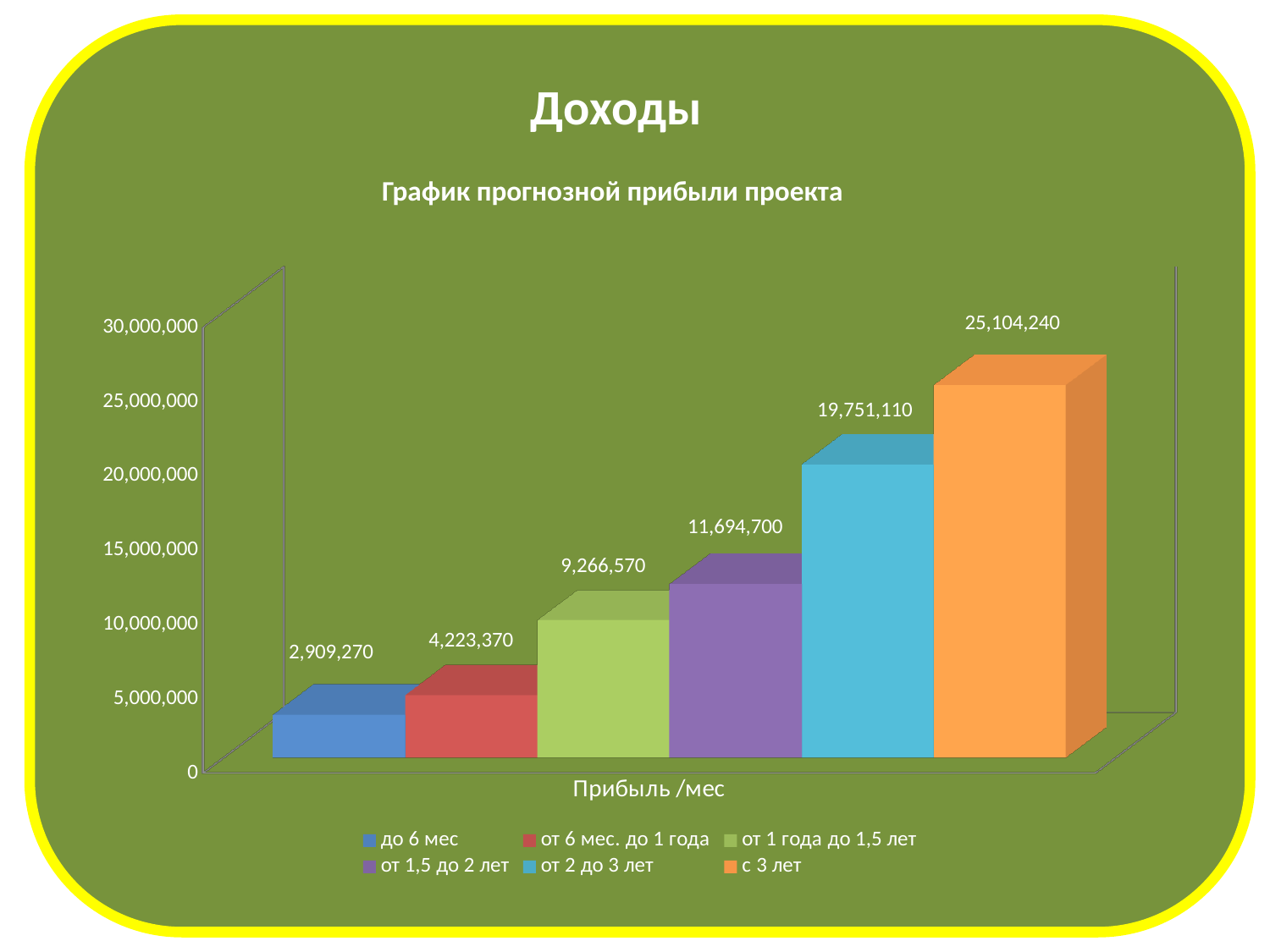
What is the title of the chart? График прогнозной прибыли проекта What kind of chart is shown on the slide? Bar chart What is the value for the series "от 2 до 3 лет"? 19,751,110 What is the value for the series "до 6 мес"? 2,909,270 How many series does the legend list? 6 Which series has the highest value? с 3 лет Which is larger: the value for "от 6 мес. до 1 года" or the value for "от 1 года до 1,5 лет"? от 1 года до 1,5 лет What is the difference between the values for "от 1,5 до 2 лет" and "от 1 года до 1,5 лет"? 2,428,130 What is the value for the series "от 1 года до 1,5 лет"? 9,266,570 Which series has the lowest value? до 6 мес What is the value for the series "с 3 лет"? 25,104,240 What is the difference between the values for "с 3 лет" and "от 2 до 3 лет"? 5,353,130